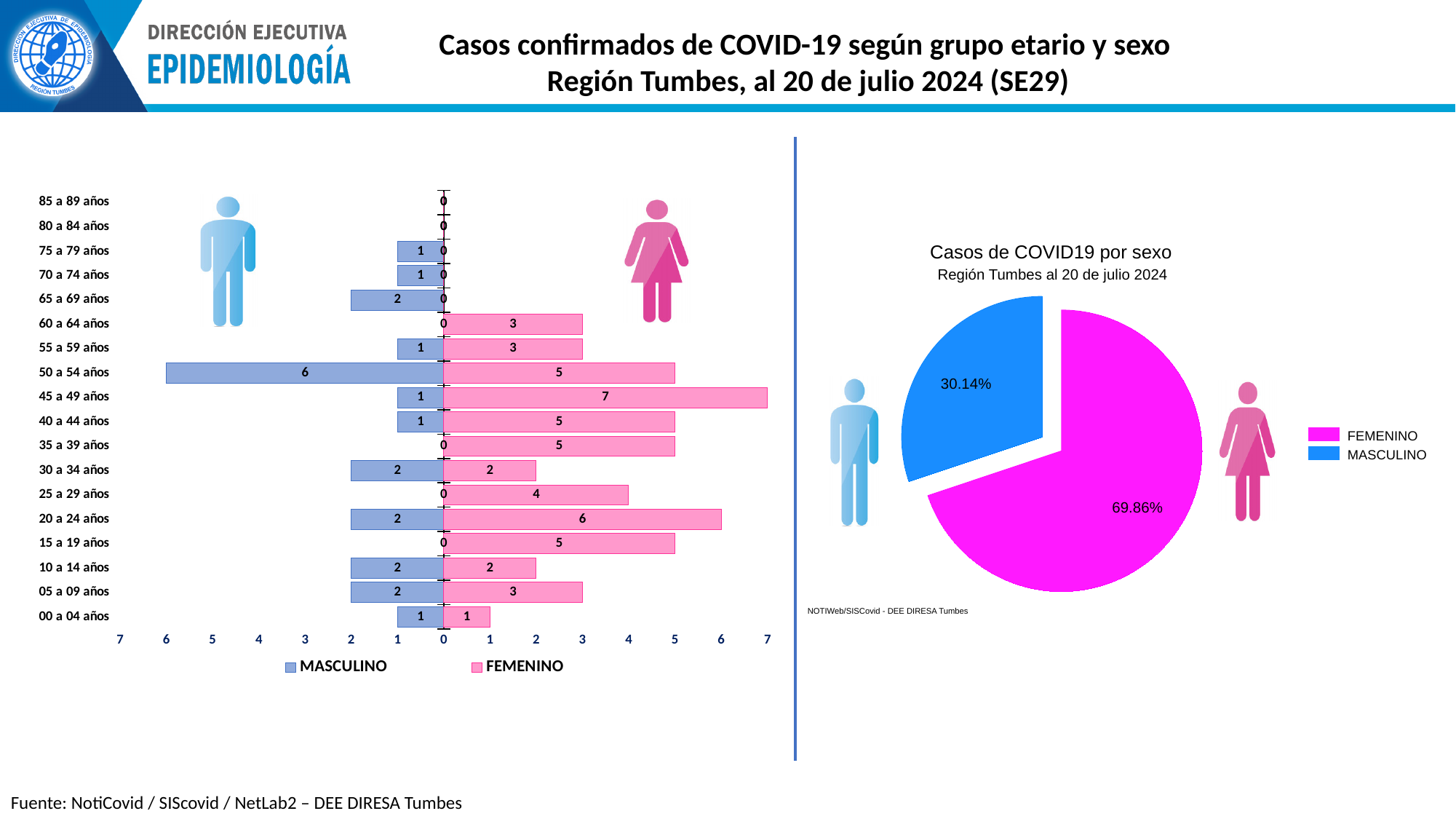
In the left chart (cases by age group and sex), how many MASCULINO cases are in the 50 a 54 años group? 6 In the left chart (cases by age group and sex), which is larger in the 50 a 54 años group: MASCULINO or FEMENINO cases? MASCULINO What kind of chart is the chart titled 'Casos de COVID19 por sexo'? Pie chart In the left chart (cases by age group and sex), how many FEMENINO cases are in the 20 a 24 años group? 6 In the left chart (cases by age group and sex), what is the total number of cases (MASCULINO plus FEMENINO) in the 20 a 24 años group? 8 In the left chart (cases by age group and sex), what is the difference between FEMENINO and MASCULINO cases in the 45 a 49 años group? 6 How many series does the legend of the left chart (cases by age group and sex) list? 2 In the pie chart 'Casos de COVID19 por sexo', what share of cases is FEMENINO? 69.86% How many age groups are shown in the left chart (cases by age group and sex)? 18 In the left chart (cases by age group and sex), how many FEMENINO cases are in the 45 a 49 años group? 7 In the left chart (cases by age group and sex), which age group has the highest number of MASCULINO cases? 50 a 54 años In the left chart (cases by age group and sex), which age group has the highest number of FEMENINO cases? 45 a 49 años